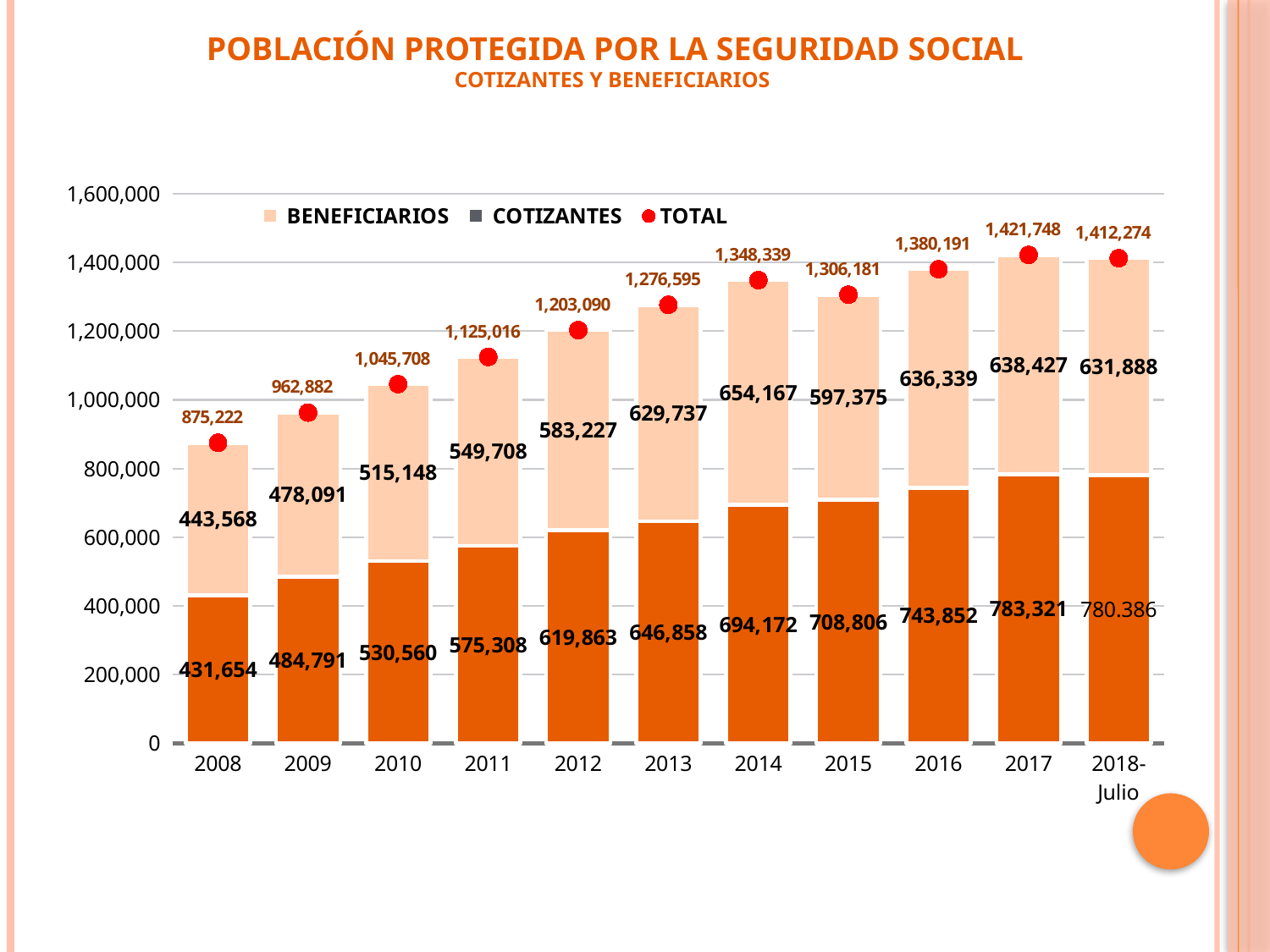
How many series does the legend list? 3 What is the difference between the BENEFICIARIOS values for 2014 and 2015? 56,792 What is the TOTAL value for 2010? 1,045,708 How many years (categories) are shown on the x axis? 11 Which is larger, the COTIZANTES value for 2016 or the BENEFICIARIOS value for 2016? COTIZANTES (743,852) What is the total of the stacked bar for 2013? 1,276,595 What is the COTIZANTES value for 2012? 619,863 Which year has the lowest COTIZANTES value? 2008 What is the BENEFICIARIOS value for 2015? 597,375 What kind of chart is shown on the slide? Stacked bar chart Which year has the highest TOTAL value? 2017 Which year has the highest BENEFICIARIOS value? 2014